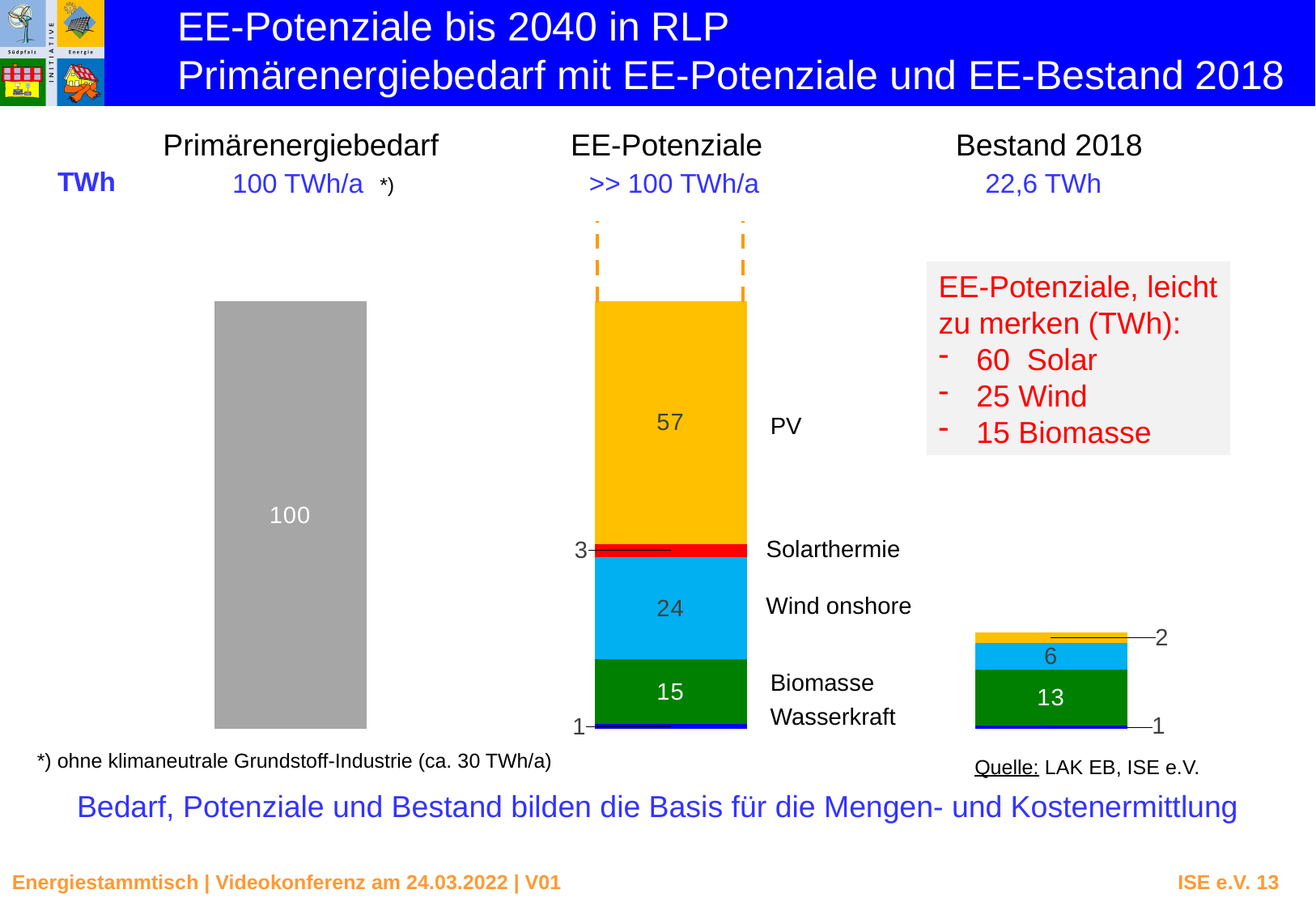
In the EE-Potenziale bar, what value is shown for Wasserkraft? 1 In the EE-Potenziale bar, what value is shown for PV? 57 In the EE-Potenziale bar, what value is shown for Biomasse? 15 In the EE-Potenziale bar, how much larger is PV than Wind onshore? 33 What value is printed on the grey Primärenergiebedarf bar? 100 In the EE-Potenziale bar, which is larger: Wind onshore or Biomasse? Wind onshore What kind of chart is used to show the EE-Potenziale? Stacked bar chart In the EE-Potenziale bar, what value is shown for Wind onshore? 24 What value is printed on the green segment of the Bestand 2018 bar? 13 Which segment of the EE-Potenziale bar is the largest? PV In the EE-Potenziale bar, what value is shown for Solarthermie? 3 Which segment of the EE-Potenziale bar is the smallest? Wasserkraft